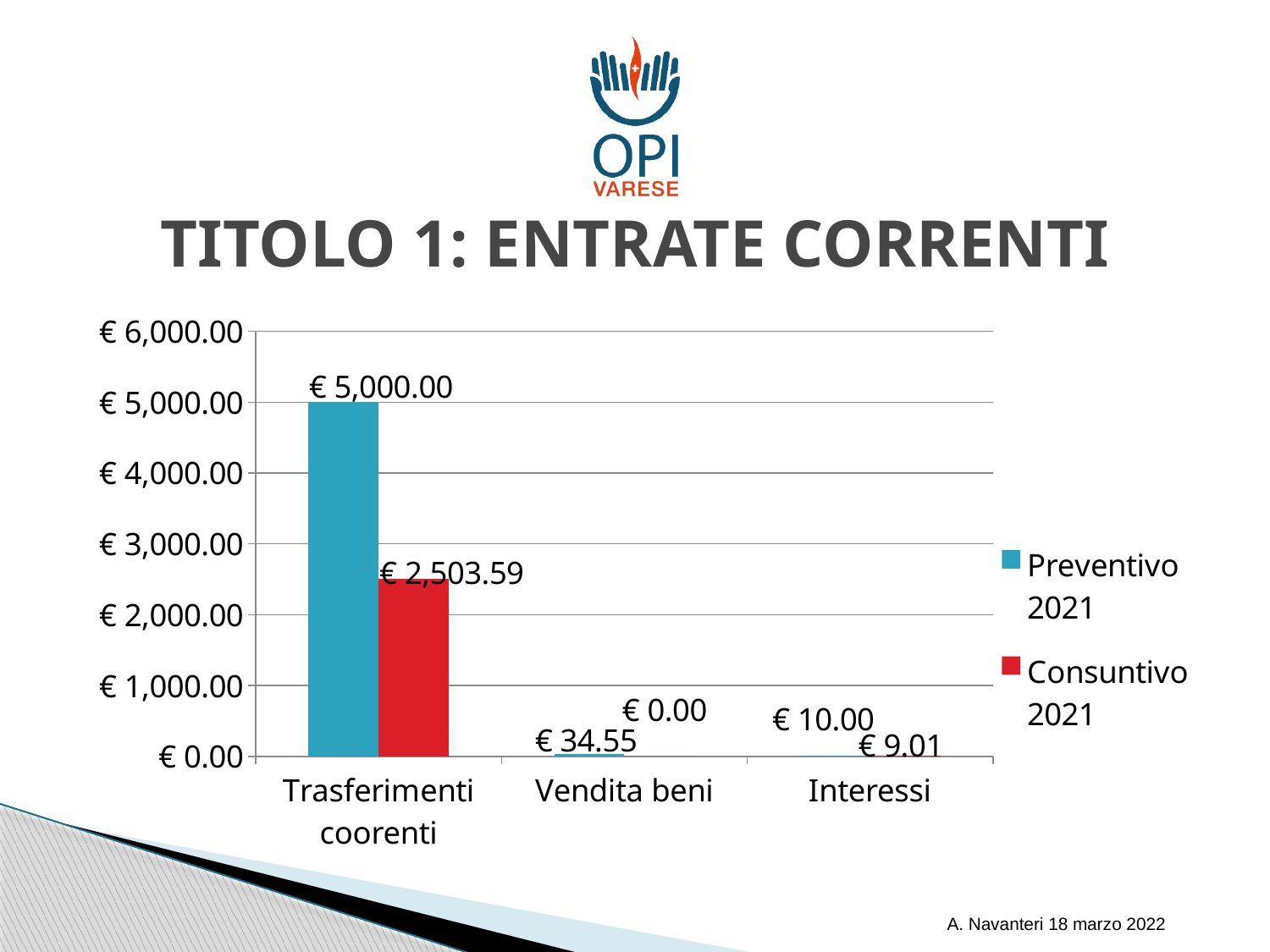
What is the difference between the Preventivo 2021 and Consuntivo 2021 values for Trasferimenti coorenti? € 2,496.41 Which category has the highest Preventivo 2021 value? Trasferimenti coorenti What is the difference between the Preventivo 2021 and Consuntivo 2021 values for Interessi? € 0.99 What kind of chart is shown on the slide? Bar chart What is the Preventivo 2021 value for Vendita beni? € 34.55 Which category has the lowest Consuntivo 2021 value? Vendita beni What is the Preventivo 2021 value for Trasferimenti coorenti? € 5,000.00 What is the Consuntivo 2021 value for Trasferimenti coorenti? € 2,503.59 What is the Consuntivo 2021 value for Interessi? € 9.01 How many categories are shown on the x axis? 3 For Trasferimenti coorenti, which is larger: Preventivo 2021 or Consuntivo 2021? Preventivo 2021 How many series does the legend list? 2